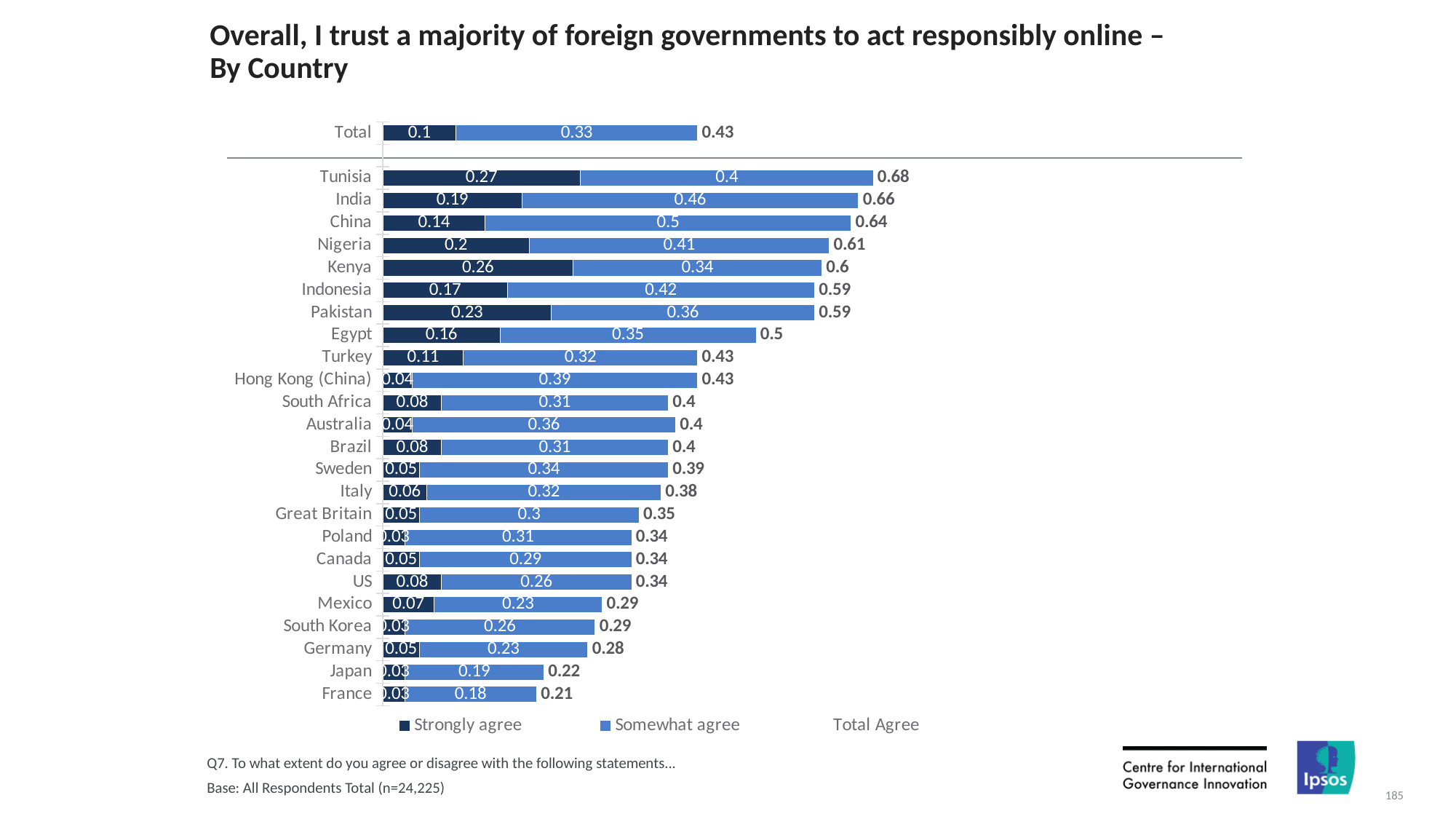
Which country has the highest Total Agree value? Tunisia What is the Total Agree value for India? 0.66 How many series does the legend list? 3 How many countries are listed in the chart (excluding the Total row)? 24 Which has a larger Strongly agree value, Kenya or Egypt? Kenya What is the title of the chart? Overall, I trust a majority of foreign governments to act responsibly online – By Country Which country has the lowest Total Agree value? France What is the Strongly agree value for Tunisia? 0.27 What kind of chart is shown on the slide? Stacked bar chart What is the Somewhat agree value for the Total row? 0.33 What is the Somewhat agree value for China? 0.5 What is the difference between the Total Agree values for Tunisia and France? 0.47